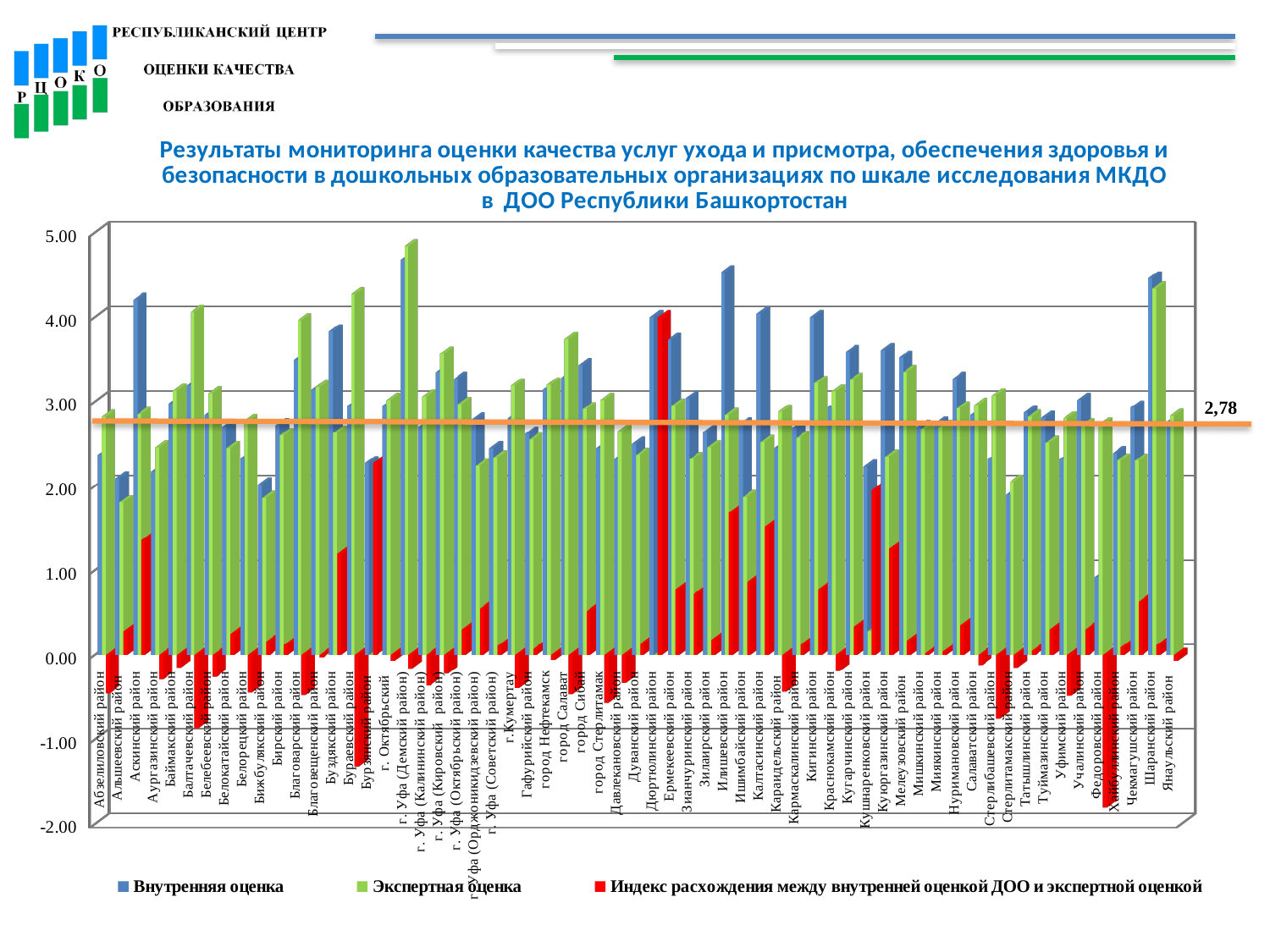
What kind of chart is shown on the slide? bar chart Which series is shown in red according to the legend? Индекс расхождения между внутренней оценкой ДОО и экспертной оценкой What value is labelled on the horizontal orange line across the chart? 2,78 Is the Внутренняя оценка value for Бижбулякский район greater or less than 3.00? less For Аскинский район, which is larger: Внутренняя оценка or Экспертная оценка? Внутренняя оценка Which category has the highest Индекс расхождения между внутренней оценкой ДОО и экспертной оценкой? Дюртюлинский район Is the Экспертная оценка value for г. Уфа (Демский район) greater or less than 4.00? greater Is the Внутренняя оценка value for Аскинский район greater or less than 3.00? greater Which category has the lowest Индекс расхождения между внутренней оценкой ДОО и экспертной оценкой? Федоровский район How many series does the legend list? 3